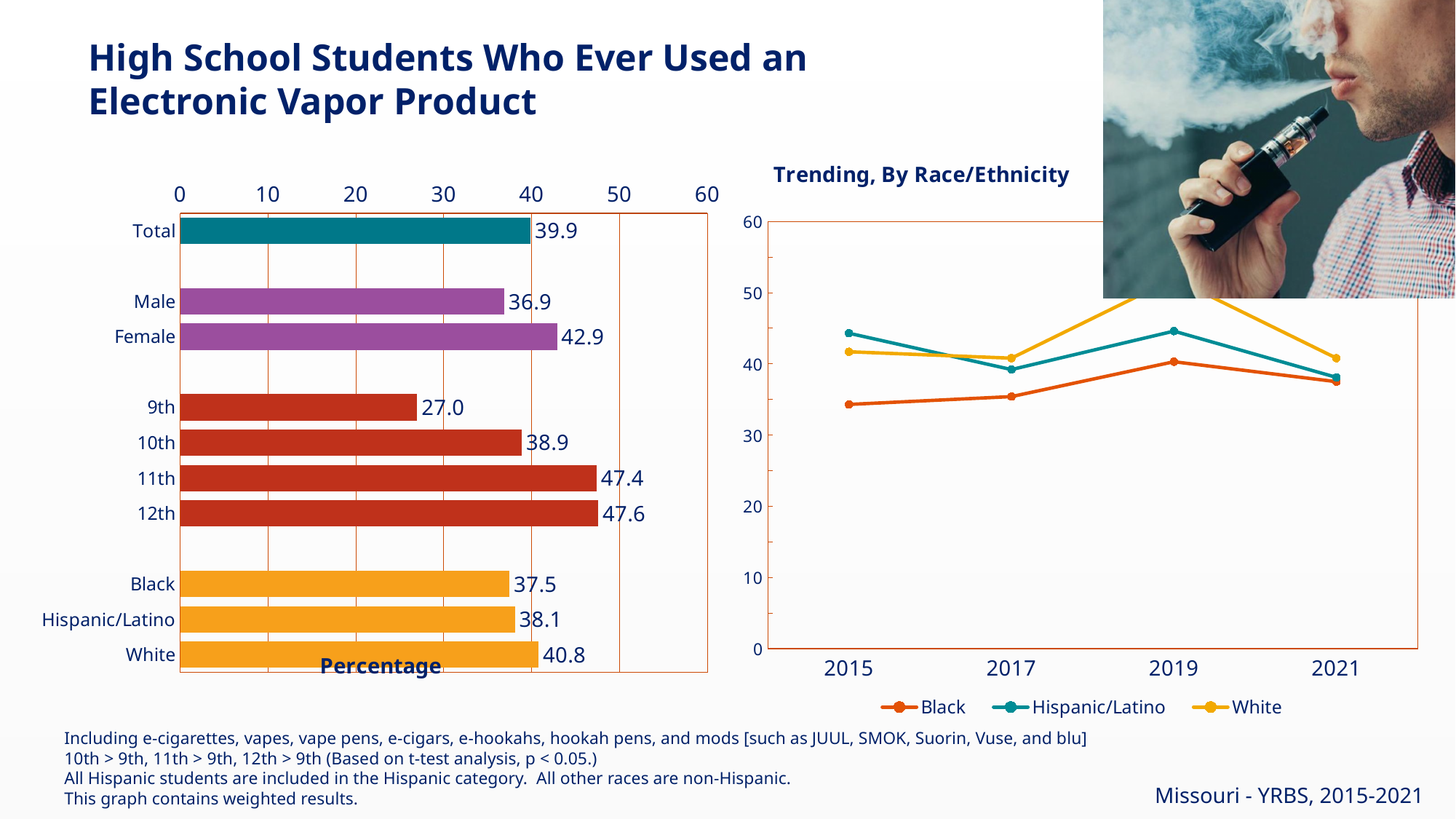
On the left bar chart, which category has the highest value? 12th On the left bar chart, what is the difference between the Female and Male values? 6.0 How many categories are shown on the left bar chart? 10 On the left bar chart, what is the value for Hispanic/Latino? 38.1 On the left bar chart, which category has the lowest value? 9th On the 'Trending, By Race/Ethnicity' chart, is the value for Hispanic/Latino in 2015 greater or less than 40? greater What kind of chart is the chart on the left? Bar chart On the 'Trending, By Race/Ethnicity' chart, is the value for Black in 2015 greater or less than 40? less On the left bar chart, what is the value for Total? 39.9 How many series does the legend of the 'Trending, By Race/Ethnicity' chart list? 3 On the left bar chart, which is larger, the value for White or the value for Black? White On the left bar chart, what is the value for 9th grade? 27.0